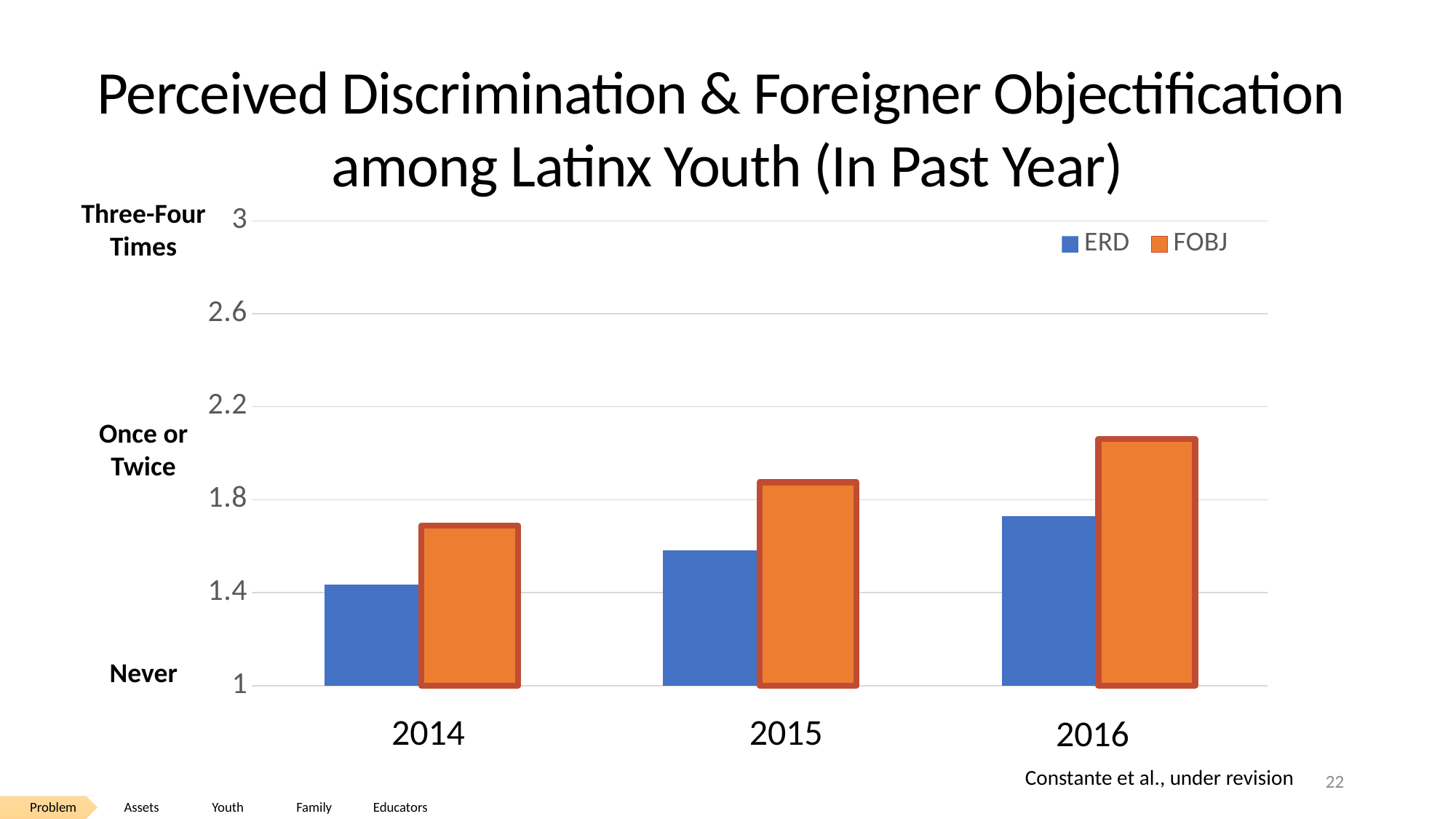
Is the FOBJ value for 2016 greater or less than 2.2? less Which year has the highest FOBJ value? 2016 Is the FOBJ value for 2015 greater or less than 1.8? greater How many series does the legend list? 2 In 2016, which is larger, ERD or FOBJ? FOBJ How many years are shown on the x axis? 3 What kind of chart is shown on the slide? bar chart What are the two series named in the legend? ERD and FOBJ What colour are the FOBJ bars? orange Do the ERD values rise or fall from 2014 to 2016? rise Is the ERD value for 2016 greater or less than 1.8? less Which year has the lowest ERD value? 2014